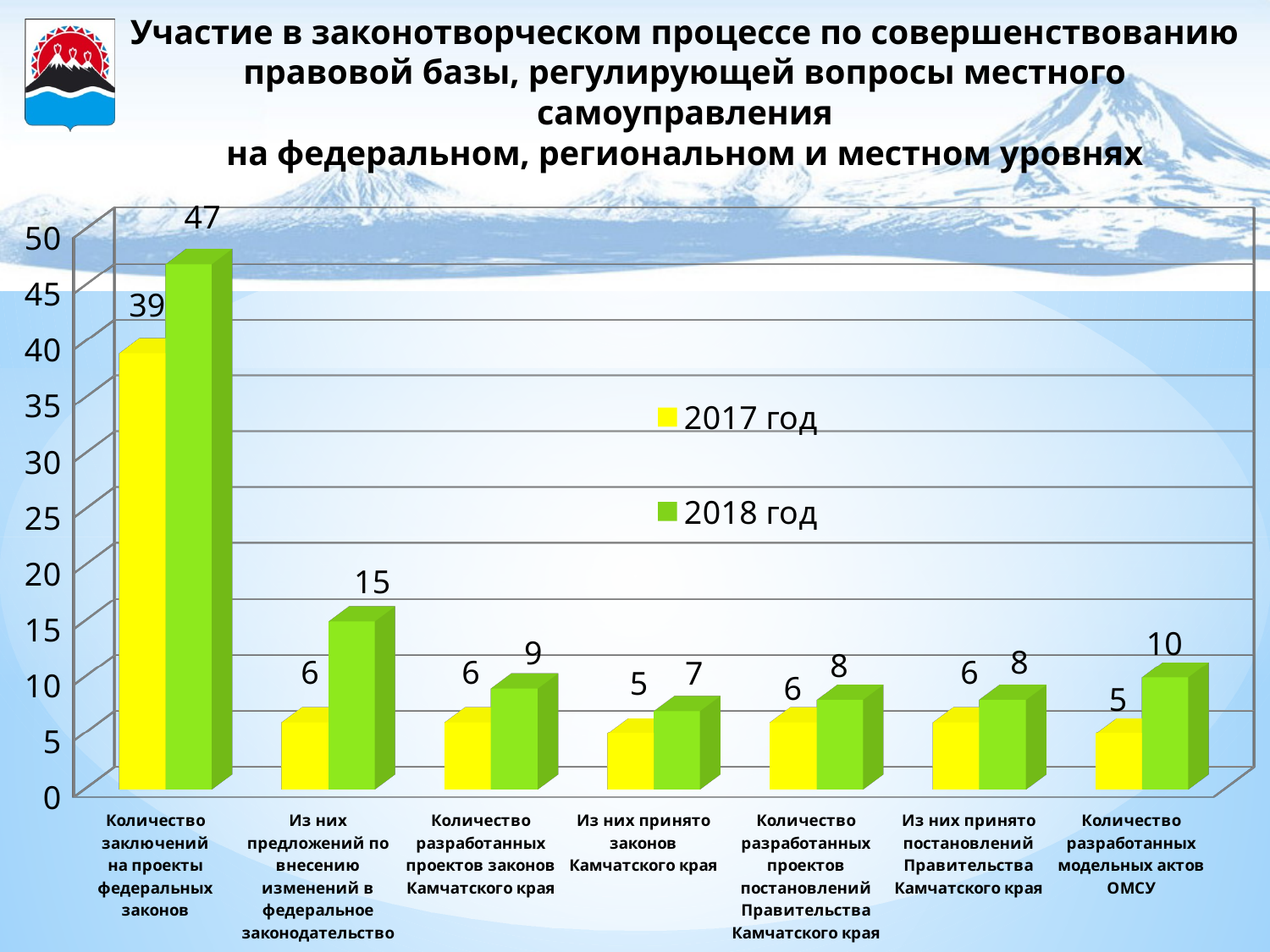
How many series does the legend list? 2 Which category has the highest value for 2018 год? Количество заключений на проекты федеральных законов Which colour represents 2018 год in the legend? green Which is larger for «Из них принято законов Камчатского края»: the 2017 год value or the 2018 год value? 2018 год What is the difference between the 2018 год and 2017 год values for «Количество заключений на проекты федеральных законов»? 8 What is the value for 2017 год for «Количество заключений на проекты федеральных законов»? 39 What is the difference between the 2018 год and 2017 год values for «Из них предложений по внесению изменений в федеральное законодательство»? 9 How many categories are shown on the x axis? 7 What kind of chart is shown on the slide? bar chart What is the value for 2018 год for «Из них предложений по внесению изменений в федеральное законодательство»? 15 Is the 2018 год value for «Количество заключений на проекты федеральных законов» greater or less than 45? greater What is the value for 2018 год for «Количество разработанных модельных актов ОМСУ»? 10